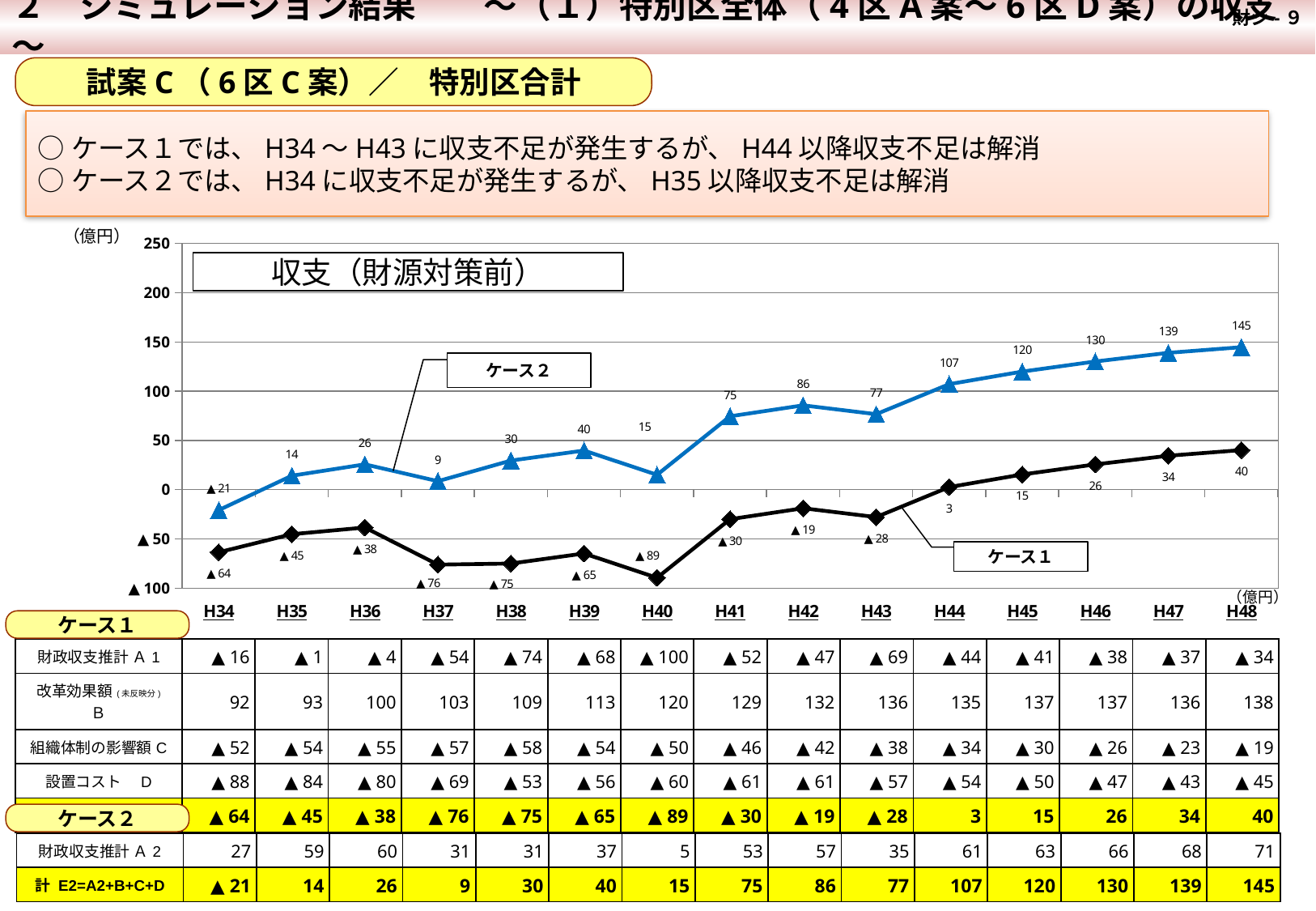
How many years (categories) are shown on the x axis of the chart? 15 In which year does ケース2 reach its highest value? H48 What is the value for ケース1 in H40? ▲89 What is the difference between ケース2 and ケース1 in H48? 105 Which series has the larger value in H41, ケース1 or ケース2? ケース2 In which year is the value for ケース1 lowest? H40 What is the value for ケース2 in H42? 86 What is the value for ケース2 in H37? 9 Do the values for ケース2 rise or fall from H44 to H48? rise What type of chart is shown on the slide? line chart What is the title shown inside the chart area? 収支（財源対策前） How many series are plotted in the chart? 2